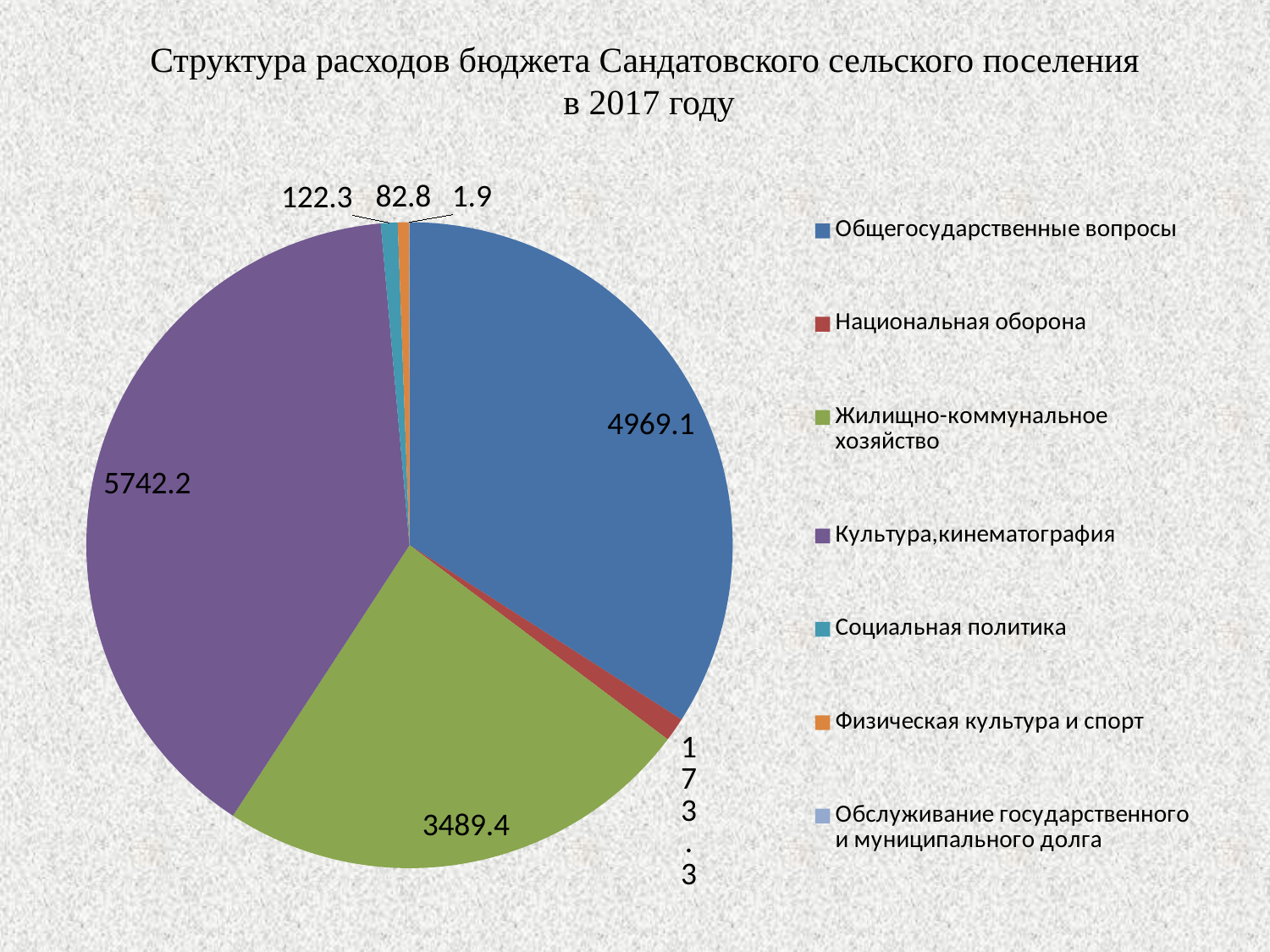
What type of chart is shown on the slide? pie chart What is the difference between the values for Культура,кинематография and Общегосударственные вопросы? 773.1 What is the value for Общегосударственные вопросы? 4969.1 What is the value for Культура,кинематография? 5742.2 What is the title of the chart? Структура расходов бюджета Сандатовского сельского поселения в 2017 году What is the value for Физическая культура и спорт? 82.8 How many categories does the legend list? 7 Which category has the smallest slice of the pie? Обслуживание государственного и муниципального долга What is the value for Жилищно-коммунальное хозяйство? 3489.4 Which category has the largest slice of the pie? Культура,кинематография Which is larger: Общегосударственные вопросы or Жилищно-коммунальное хозяйство? Общегосударственные вопросы What is the value for Социальная политика? 122.3